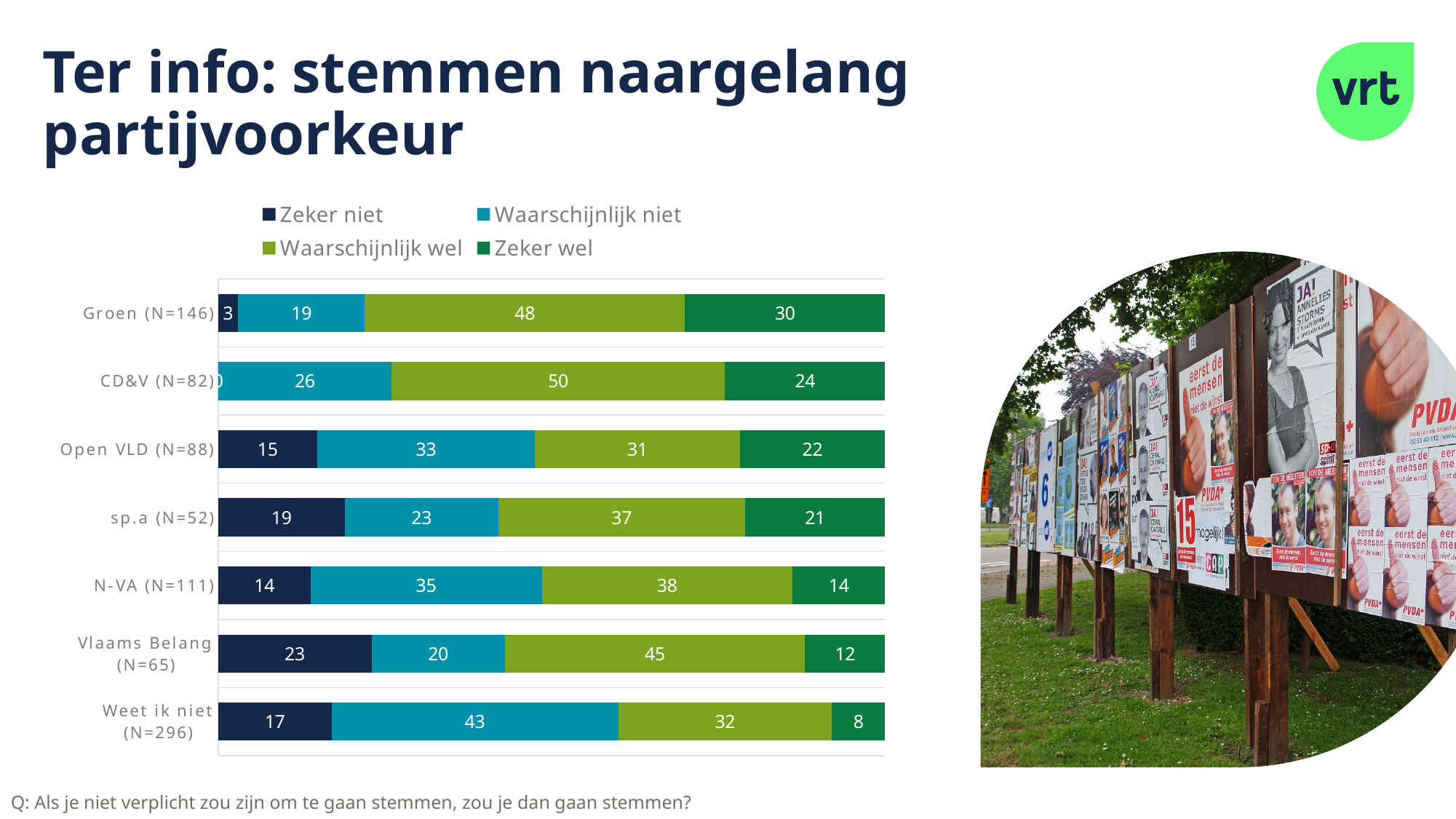
What is the value for "Waarschijnlijk niet" for Weet ik niet (N=296)? 43 How many categories (bars) are shown in the chart? 7 Which category has the lowest value for "Zeker wel"? Weet ik niet (N=296) What is the value for "Zeker niet" for sp.a (N=52)? 19 Which has the larger "Waarschijnlijk niet" value: sp.a (N=52) or Vlaams Belang (N=65)? sp.a (N=52) What is the total of the stacked bar for Groen (N=146)? 100 Which category has the highest value for "Zeker niet"? Vlaams Belang (N=65) What is the value for "Zeker wel" for Groen (N=146)? 30 Which legend entry is shown in dark green? Zeker wel How many series does the legend list? 4 What kind of chart is shown on the slide? Stacked bar chart What is the difference between the "Waarschijnlijk wel" values for CD&V (N=82) and Open VLD (N=88)? 19